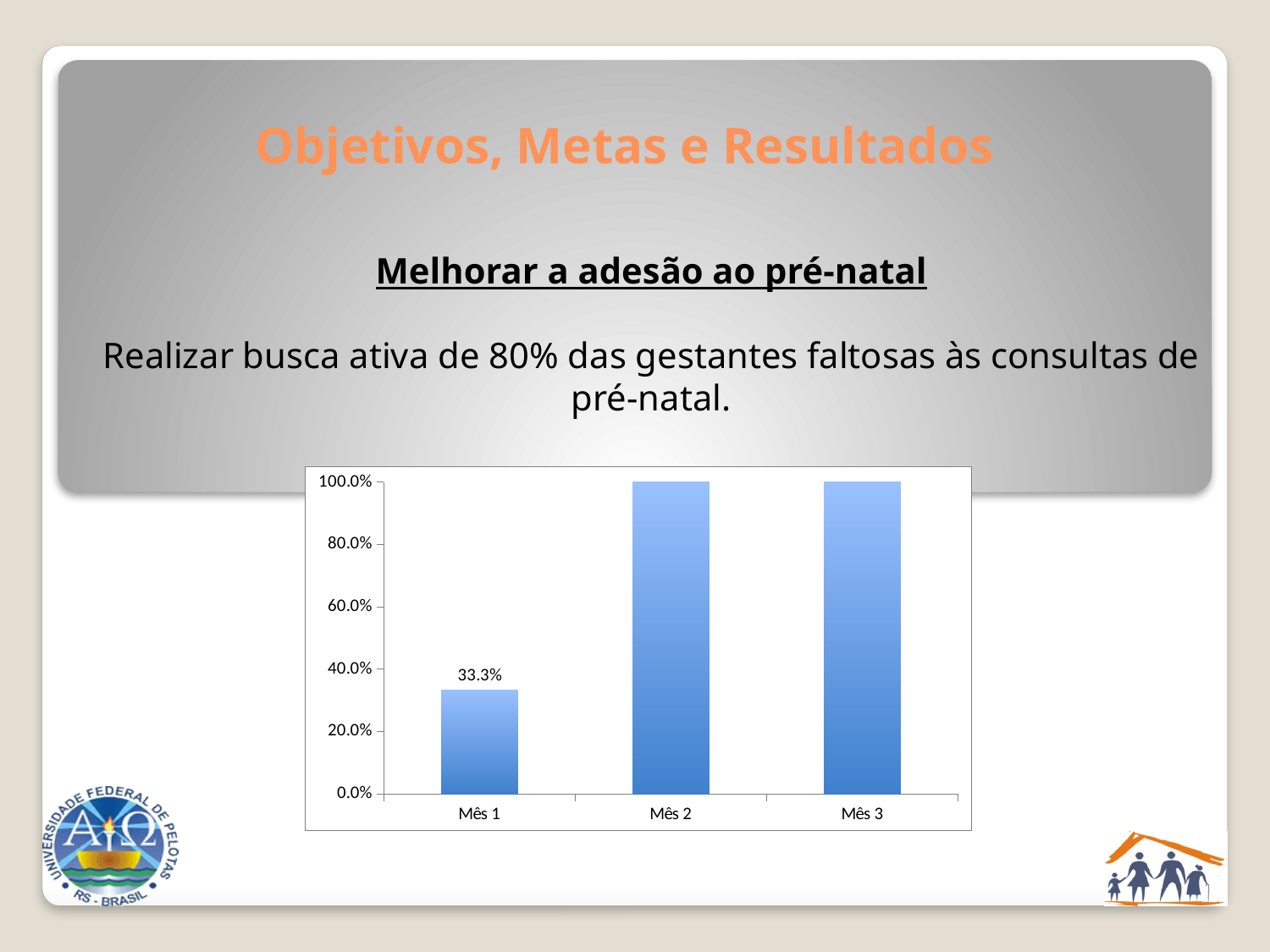
Is the value for Mês 3 greater or less than 80.0%? greater Is the value for Mês 1 greater or less than 40.0%? less What value does the bar for Mês 3 reach on the y axis? 100.0% Which is larger, the value for Mês 1 or the value for Mês 2? Mês 2 What value does the bar for Mês 2 reach on the y axis? 100.0% Do the values rise or fall from Mês 1 to Mês 2? rise How many categories are shown on the x axis? 3 What is the value for Mês 1? 33.3% What kind of chart is shown on the slide? bar chart What is the difference between the values for Mês 2 and Mês 1? 66.7% Which month has the lowest value? Mês 1 What is the highest value shown on the y axis? 100.0%